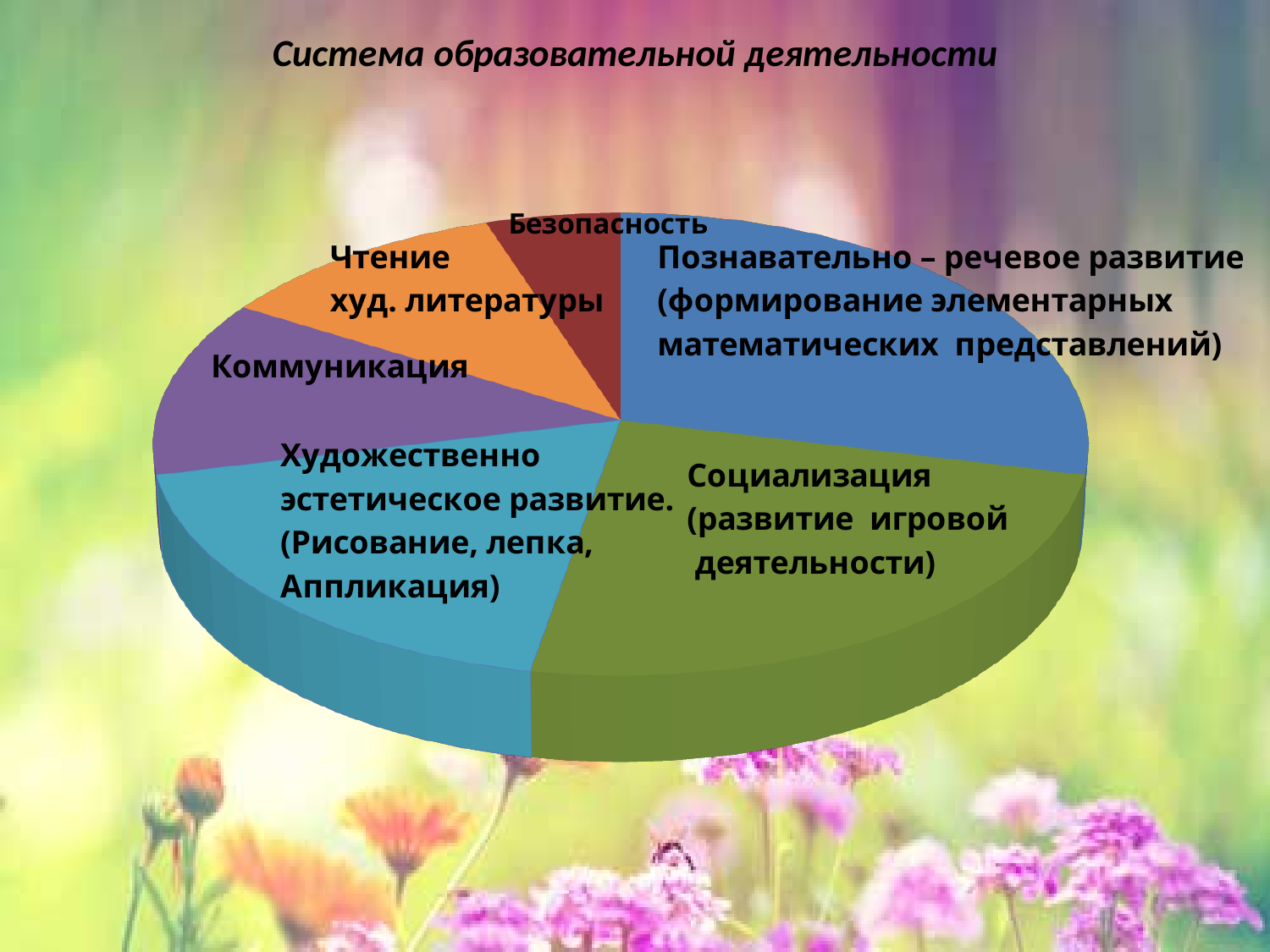
Which slice is larger: Социализация or Чтение худ. литературы? Социализация Which category has the largest slice of the pie chart? Познавательно – речевое развитие (формирование элементарных математических представлений) How many slices does the pie chart have? 6 Which slice is larger: Социализация or Безопасность? Социализация Which slice is larger: Художественно эстетическое развитие or Безопасность? Художественно эстетическое развитие Which category has the smallest slice of the pie chart? Безопасность What colour is the slice labelled Коммуникация? Purple What is the title of the slide containing the pie chart? Система образовательной деятельности What kind of chart is shown on the slide? Pie chart